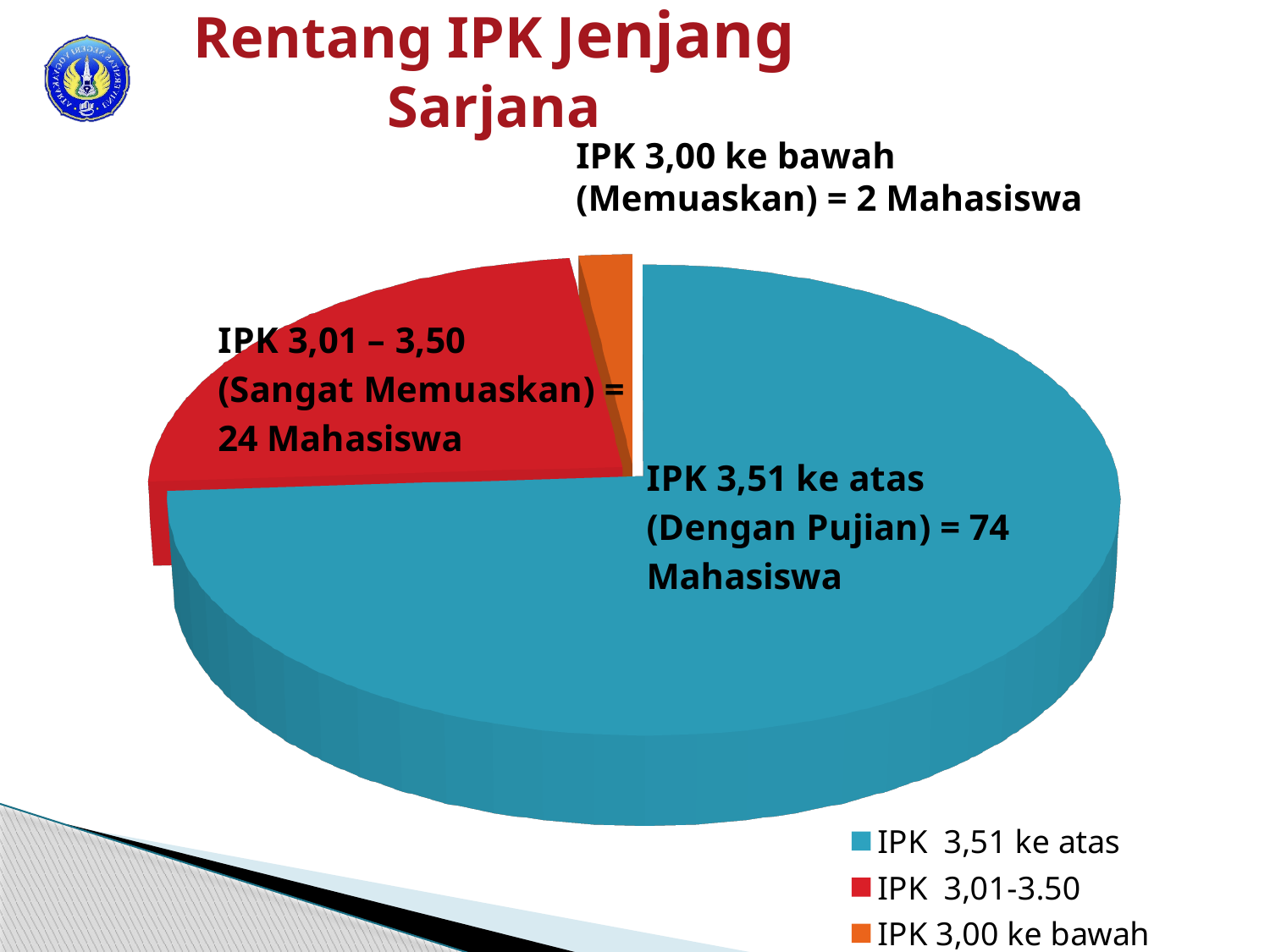
What share of the pie does the IPK 3,51 ke atas slice represent? 74% What is the difference in the number of students between IPK 3,51 ke atas and IPK 3,01 – 3,50? 50 What colour is the slice for IPK 3,00 ke bawah? orange How many students have an IPK of 3,51 ke atas (Dengan Pujian)? 74 Mahasiswa Which IPK category has the largest number of students? IPK 3,51 ke atas Which IPK category has the smallest number of students? IPK 3,00 ke bawah How many categories does the pie chart have? 3 How many students have an IPK of 3,01 – 3,50 (Sangat Memuaskan)? 24 Mahasiswa Which has more students: IPK 3,01 – 3,50 or IPK 3,00 ke bawah? IPK 3,01 – 3,50 What kind of chart is shown on the slide? pie chart How many students have an IPK of 3,00 ke bawah (Memuaskan)? 2 Mahasiswa What is the difference in the number of students between IPK 3,01 – 3,50 and IPK 3,00 ke bawah? 22